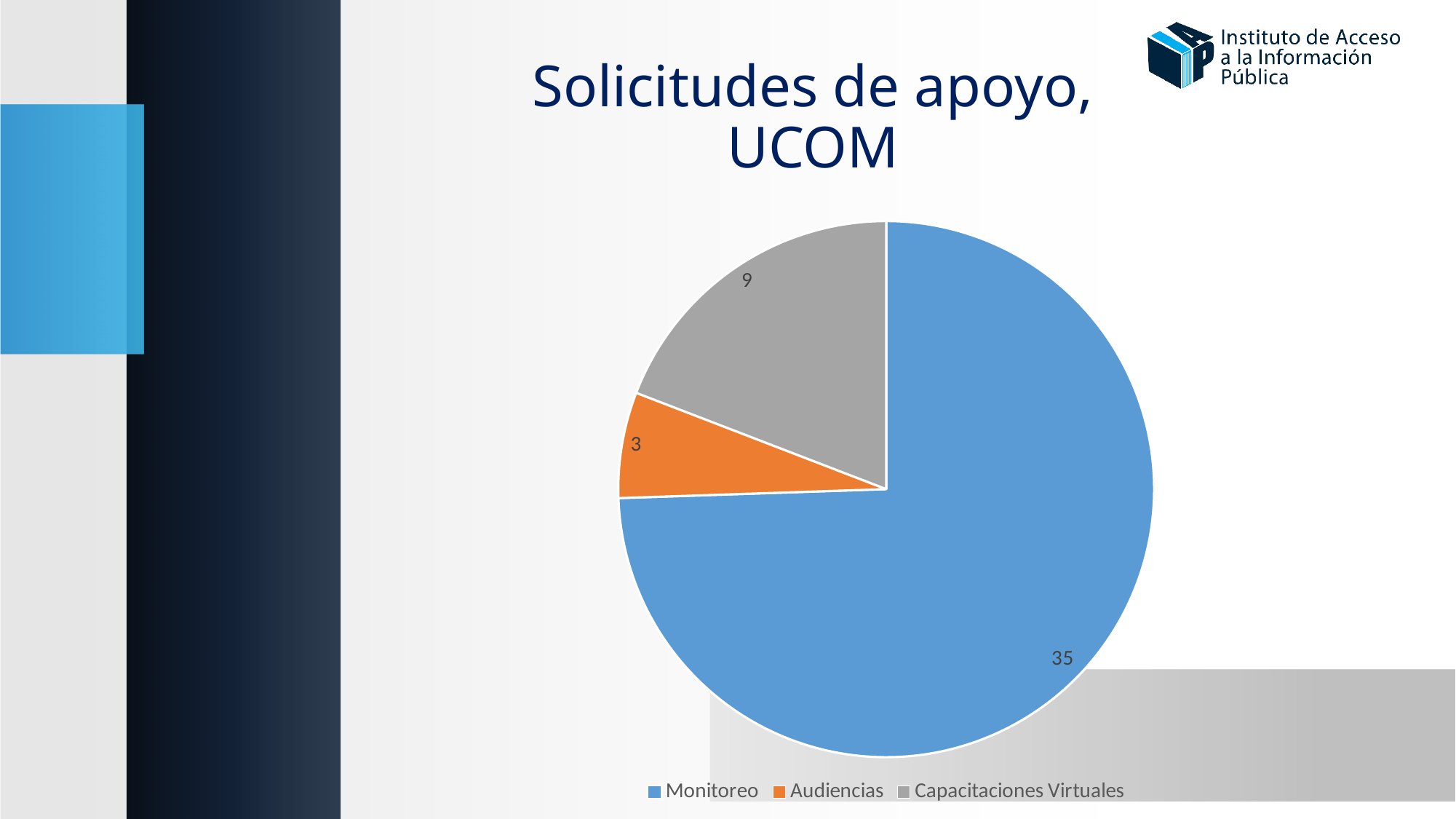
What is the difference between the values for Capacitaciones Virtuales and Audiencias? 6 What is the value for Audiencias? 3 What type of chart is shown on the slide? Pie chart What is the title of the chart on the slide? Solicitudes de apoyo, UCOM Which category has the smallest slice? Audiencias What is the difference between the values for Monitoreo and Capacitaciones Virtuales? 26 Which category has the largest slice? Monitoreo What is the total of all slices in the pie chart? 47 Which is larger, Capacitaciones Virtuales or Audiencias? Capacitaciones Virtuales What is the value for Capacitaciones Virtuales? 9 How many categories does the pie chart have? 3 What is the value for Monitoreo? 35